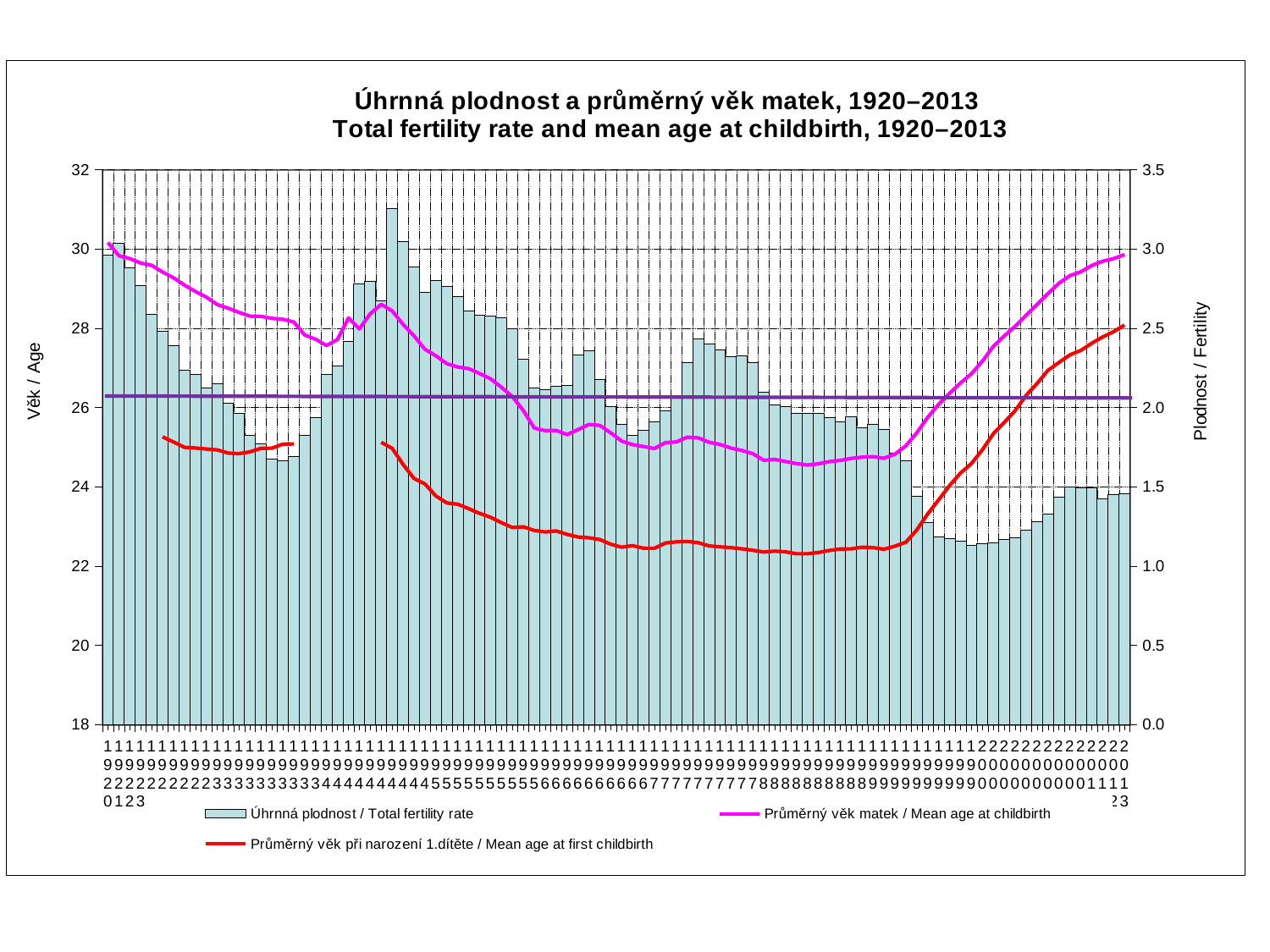
How many series does the legend list? 3 Is the mean age at first childbirth (red line) at the end of the period, in 2013, greater or less than 27? greater What kind of chart is shown on the slide? A combined bar and line chart Is the highest total fertility rate bar on the chart greater or less than 3.0? greater Is the lowest total fertility rate bar on the chart greater or less than 1.5? less Does the mean age at childbirth (magenta line) rise or fall over the last two decades of the period, from the 1990s to 2013? Rise What is the label of the right-hand vertical axis? Plodnost / Fertility What is the English part of the chart title? Total fertility rate and mean age at childbirth, 1920–2013 Does the mean age at first childbirth (red line) rise or fall from 1950 to 1980? Fall Which is higher in 2013: the mean age at childbirth or the mean age at first childbirth? Mean age at childbirth